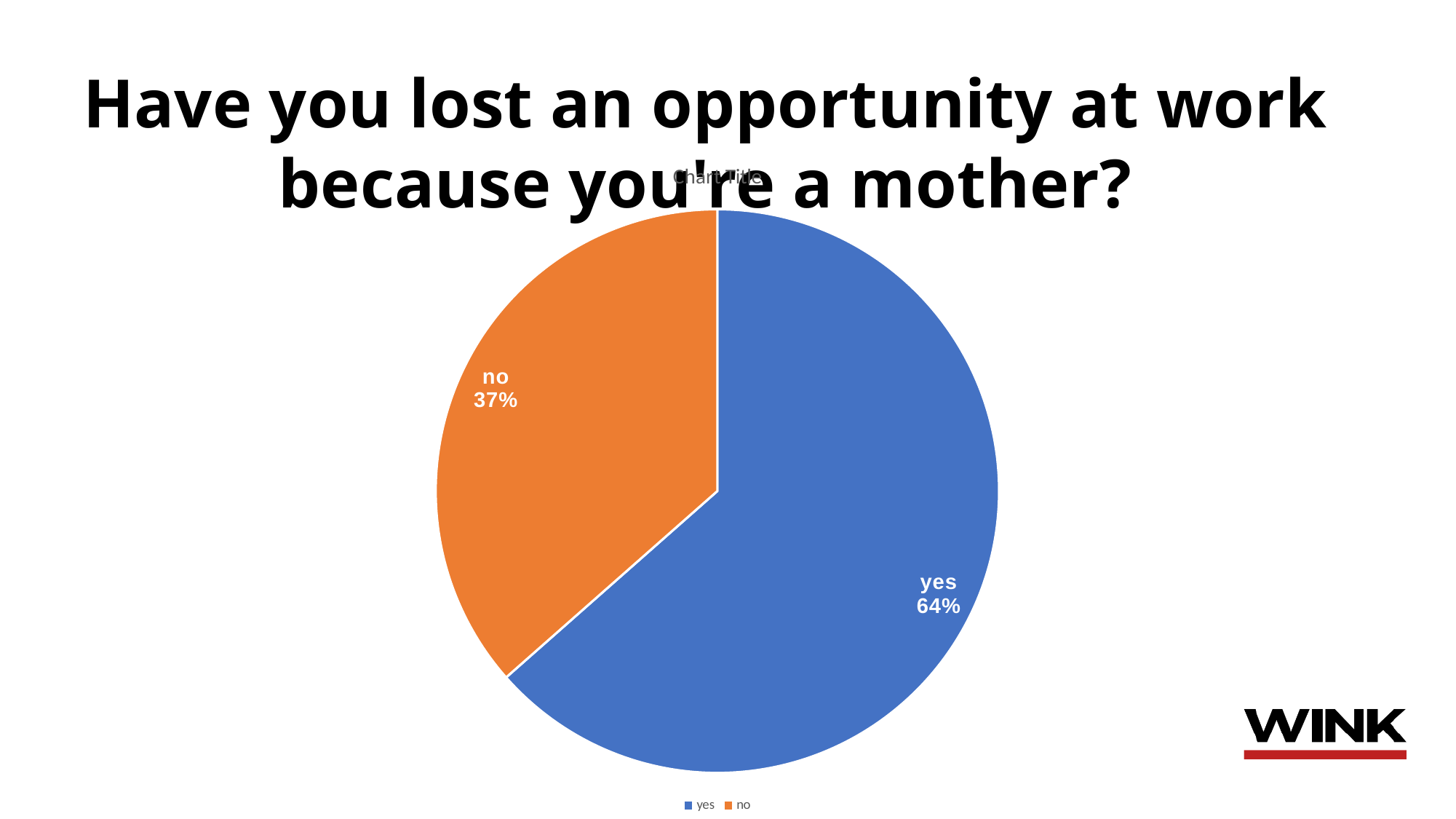
What colour is the "yes" slice? blue Which response has the largest share of the pie? yes How many slices does the pie chart have? 2 What percentage of respondents answered "no"? 37% How many entries does the legend list? 2 What colour is the "no" slice? orange What type of chart is shown on the slide? pie chart What percentage of respondents answered "yes"? 64% What is the difference in percentage points between the "yes" and "no" slices? 27 Which slice is larger, "yes" or "no"? yes Which response has the smallest share of the pie? no Is the share for "yes" greater or less than 50%? greater